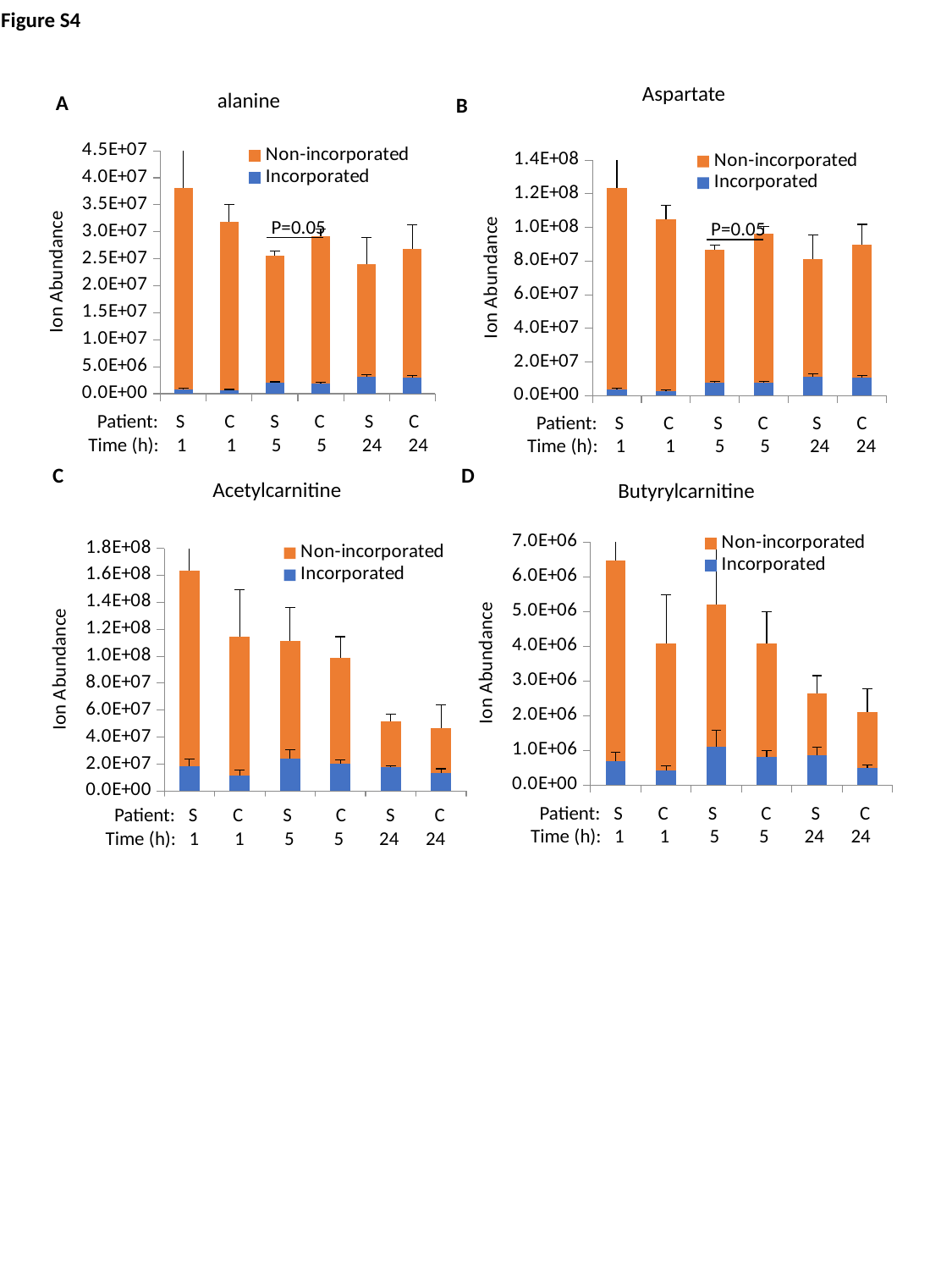
In the Acetylcarnitine chart (panel C), which bar has the highest total ion abundance? Patient S, 1 h In the Aspartate chart (panel B), is the total ion abundance for Patient S at 5 h greater or less than 1.0E+08? less In the alanine chart (panel A), which bar has the highest total ion abundance? Patient S, 1 h How many bars are plotted in the Acetylcarnitine chart (panel C)? 6 In the Butyrylcarnitine chart (panel D), is the total ion abundance for Patient C at 24 h greater or less than 3.0E+06? less In the Aspartate chart (panel B), which bar has the highest total ion abundance? Patient S, 1 h In the Acetylcarnitine chart (panel C), is the total ion abundance for Patient S at 1 h greater or less than 1.4E+08? greater How many series does the legend list in the Aspartate chart (panel B)? 2 In the alanine chart (panel A), which bar has the larger total ion abundance: Patient S at 1 h or Patient C at 1 h? Patient S at 1 h In the Butyrylcarnitine chart (panel D), which bar has the lowest total ion abundance? Patient C, 24 h What colour represents the Incorporated series in the Butyrylcarnitine chart (panel D)? blue What kind of chart is the alanine chart (panel A)? stacked bar chart